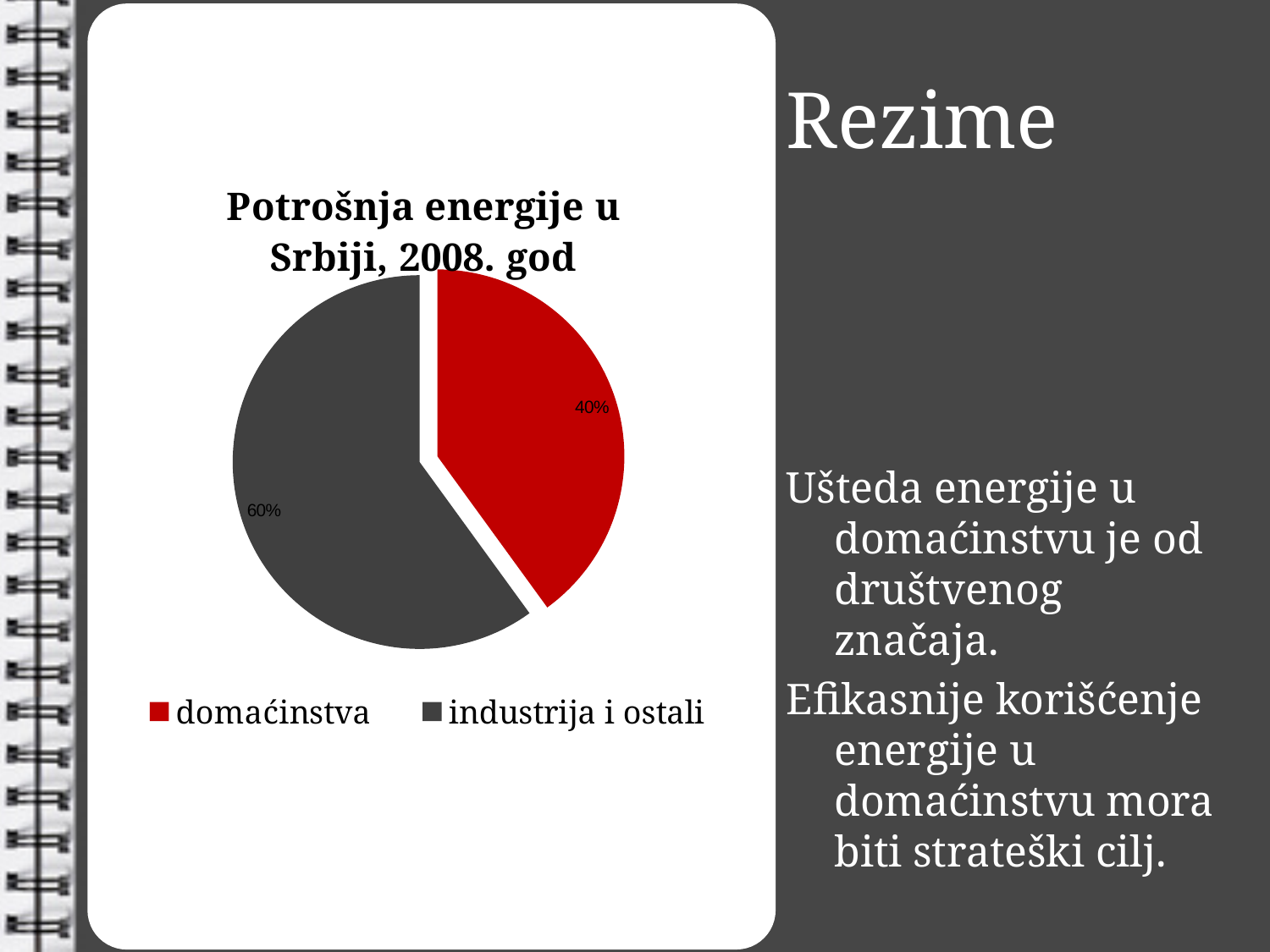
Which category has the largest share of the pie? industrija i ostali Which is larger, the share for 'domaćinstva' or the share for 'industrija i ostali'? industrija i ostali What share of the pie does 'industrija i ostali' have? 60% What share of the pie does 'domaćinstva' have? 40% What is the difference in percentage points between 'industrija i ostali' and 'domaćinstva'? 20% How many slices does the pie chart have? 2 Which category has the smallest share of the pie? domaćinstva What kind of chart is shown on the slide? pie chart What colour is the 'domaćinstva' slice? red How many entries does the legend list? 2 What is the title of the chart? Potrošnja energije u Srbiji, 2008. god